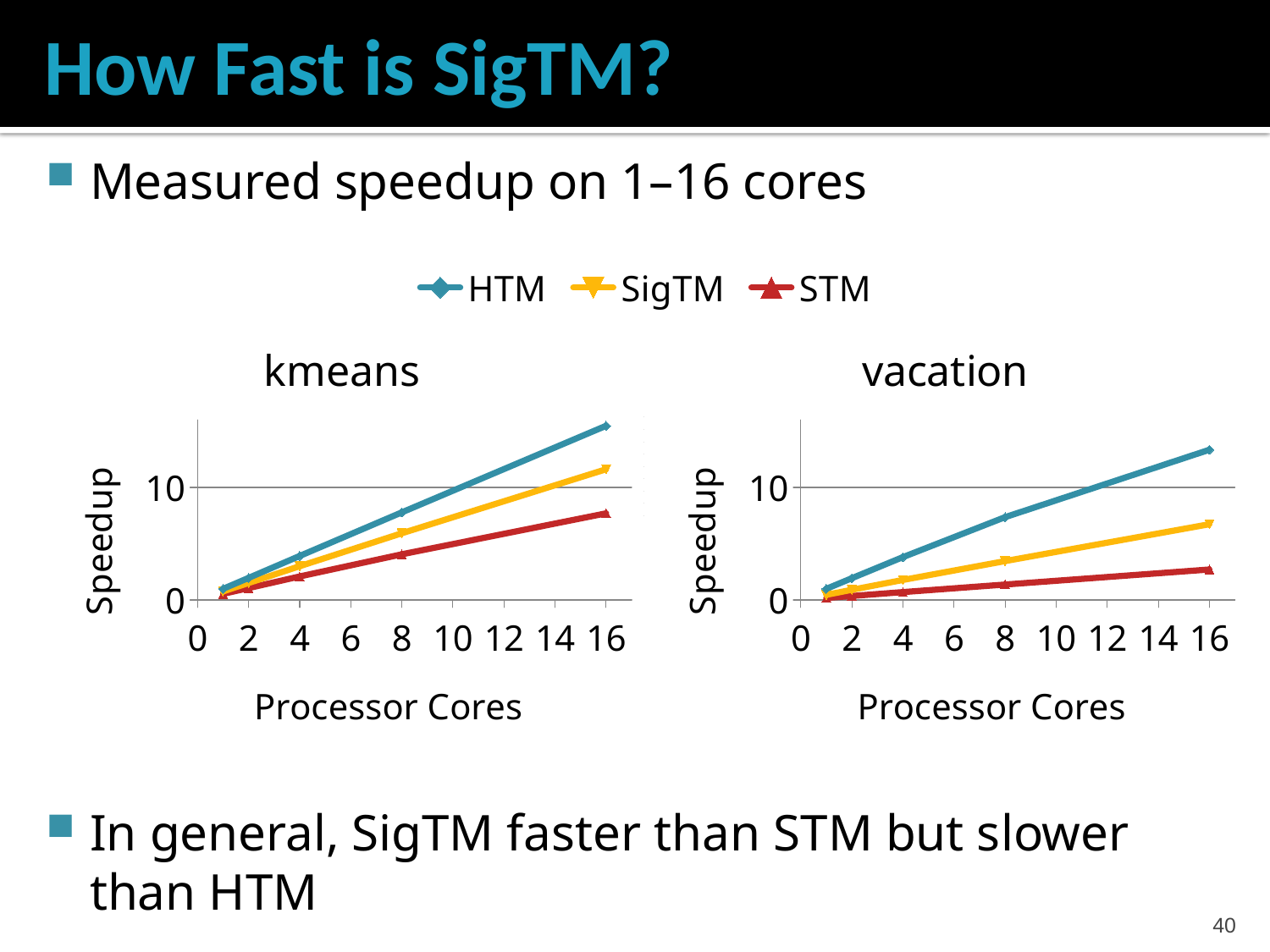
How many series does the legend list? 3 In the kmeans chart, does the HTM speedup rise or fall as the number of processor cores increases? rise In the vacation chart, is the SigTM speedup at 16 processor cores greater or less than 10? less In the kmeans chart, which series has the lowest speedup at 16 processor cores? STM What kind of chart is the kmeans chart? line chart In the vacation chart, which is larger at 16 processor cores, the SigTM speedup or the STM speedup? SigTM In the kmeans chart, is the HTM speedup at 16 processor cores greater or less than 10? greater In the kmeans chart, is the STM speedup at 16 processor cores greater or less than 10? less In the kmeans chart, which series has the highest speedup at 16 processor cores? HTM In the vacation chart, which series has the highest speedup at 16 processor cores? HTM In the vacation chart, which series has the lowest speedup at 16 processor cores? STM